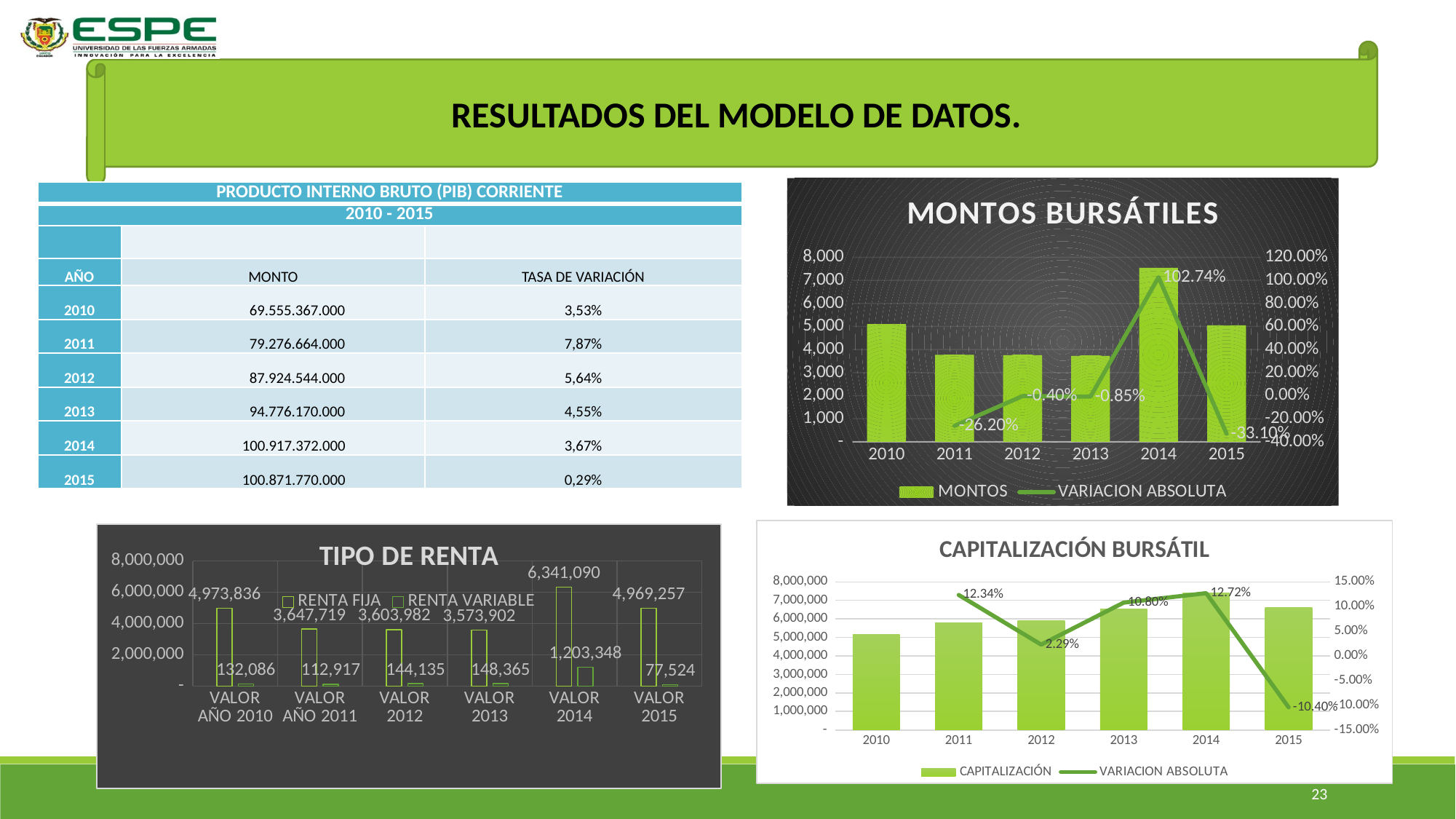
In the CAPITALIZACIÓN BURSÁTIL chart, which year has the lowest CAPITALIZACIÓN bar? 2010 In the TIPO DE RENTA chart, what is the RENTA VARIABLE value for VALOR 2015? 77,524 In the MONTOS BURSÁTILES chart, how many series does the legend list? 2 In the TIPO DE RENTA chart, which category has the lowest RENTA VARIABLE value? VALOR 2015 In the CAPITALIZACIÓN BURSÁTIL chart, is the VARIACION ABSOLUTA for 2012 larger or smaller than for 2013? smaller In the CAPITALIZACIÓN BURSÁTIL chart, what is the VARIACION ABSOLUTA value for 2015? -10.40% In the TIPO DE RENTA chart, what is the RENTA FIJA value for VALOR 2014? 6,341,090 In the TIPO DE RENTA chart, what is the difference between RENTA FIJA and RENTA VARIABLE for VALOR 2014? 5,137,742 In the MONTOS BURSÁTILES chart, what is the VARIACION ABSOLUTA value for 2011? -26.20% In the MONTOS BURSÁTILES chart, is the MONTOS value for 2014 greater or less than 7,000? greater In the MONTOS BURSÁTILES chart, what is the VARIACION ABSOLUTA value for 2014? 102.74% In the MONTOS BURSÁTILES chart, which year has the highest MONTOS bar? 2014